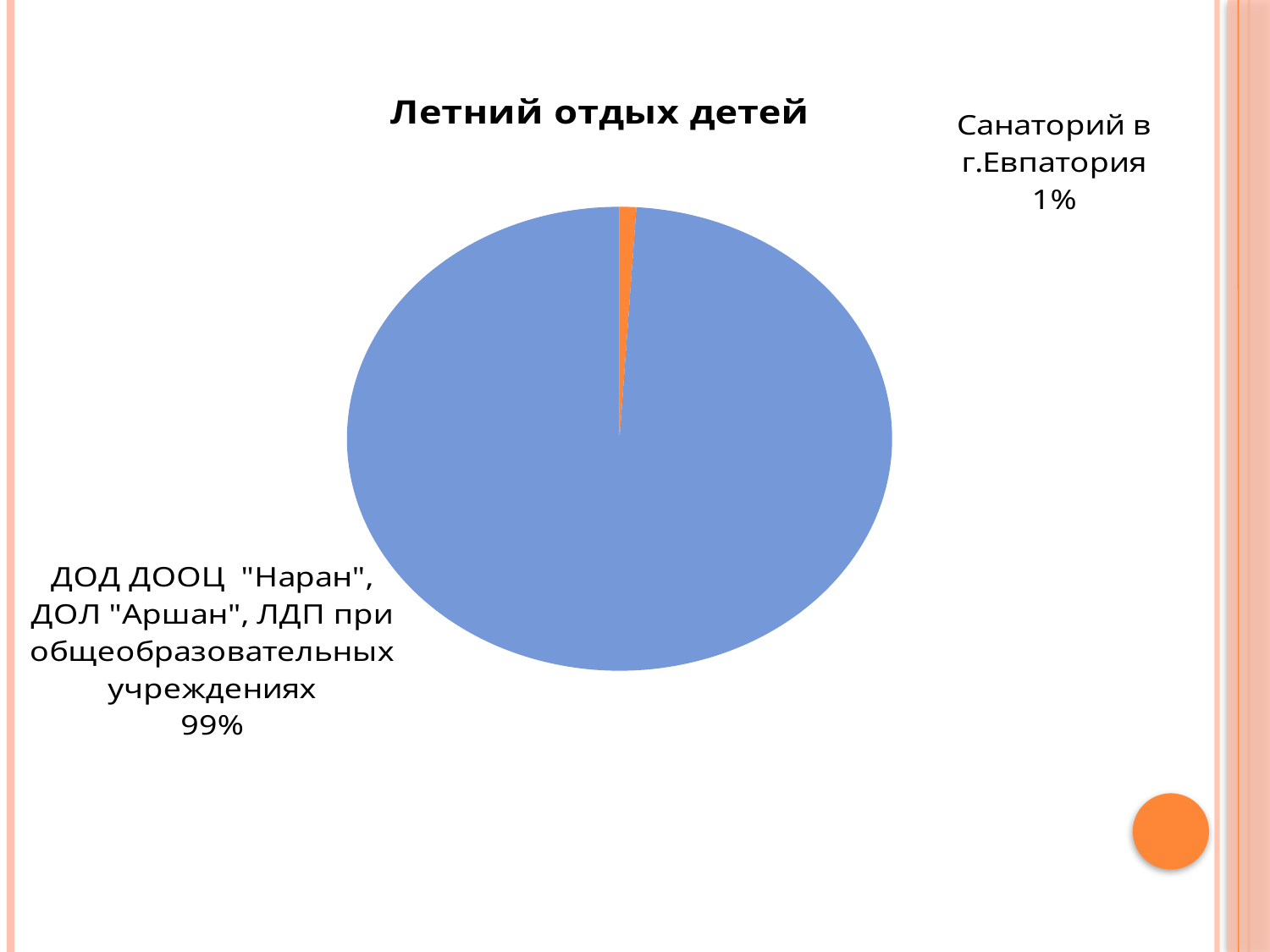
What kind of chart is shown on the slide? pie chart What is the title of the chart? Летний отдых детей What colour is the slice for Санаторий в г.Евпатория? orange What share of the pie does ДОД ДООЦ "Наран", ДОЛ "Аршан", ЛДП при общеобразовательных учреждениях have? 99% What is the difference in percentage points between the two slices of the pie? 98 Which category has the largest slice of the pie? ДОД ДООЦ "Наран", ДОЛ "Аршан", ЛДП при общеобразовательных учреждениях Which category has the smallest slice of the pie? Санаторий в г.Евпатория How many slices does the pie chart have? 2 Which is larger: the share for Санаторий в г.Евпатория or the share for ДОД ДООЦ "Наран", ДОЛ "Аршан", ЛДП при общеобразовательных учреждениях? ДОД ДООЦ "Наран", ДОЛ "Аршан", ЛДП при общеобразовательных учреждениях What share of the pie does Санаторий в г.Евпатория have? 1%